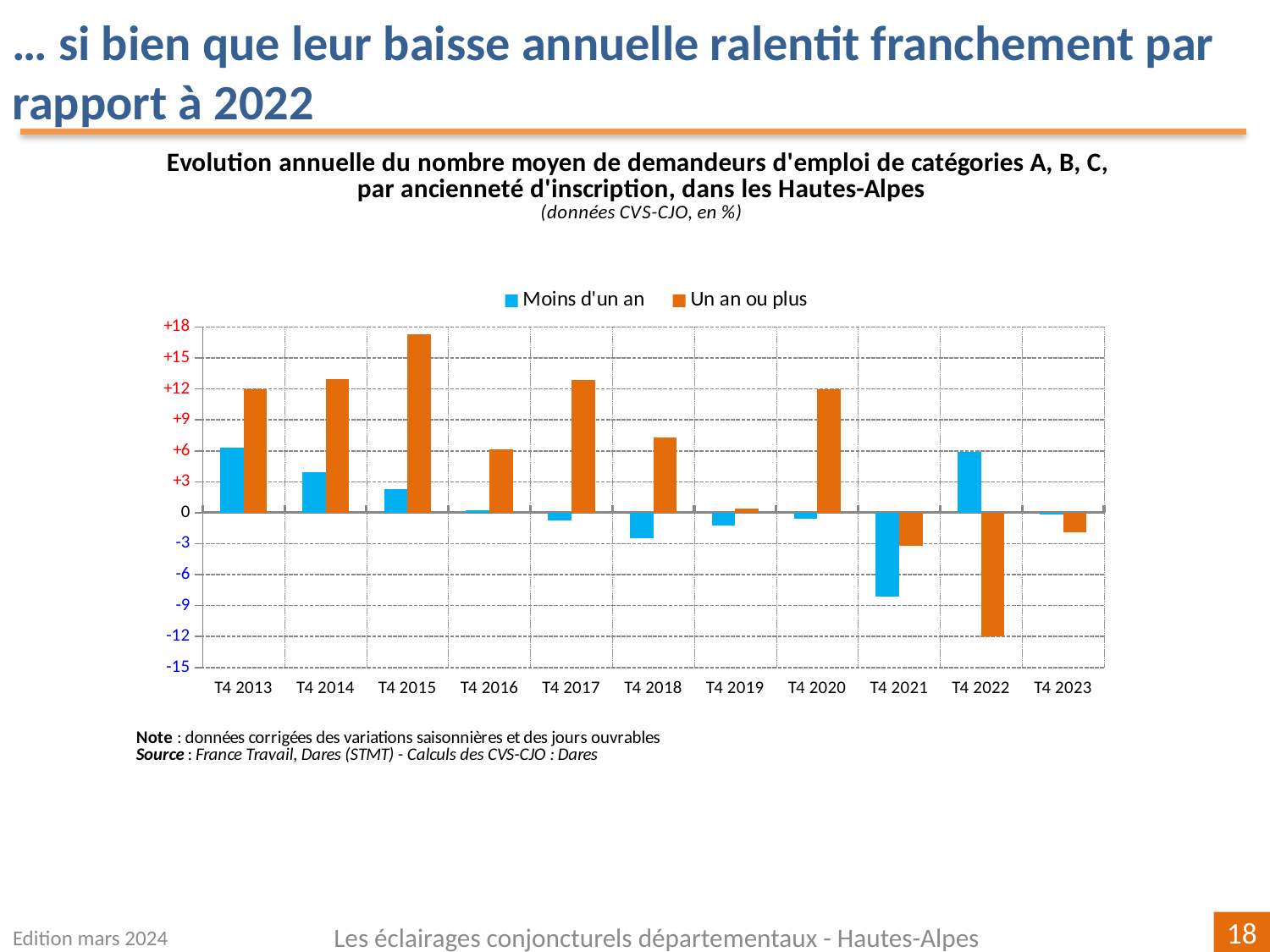
In which quarter is the value for 'Moins d'un an' the lowest? T4 2021 How many series does the legend list? 2 In T4 2022, which series has the higher value, 'Moins d'un an' or 'Un an ou plus'? Moins d'un an What kind of chart is shown on the slide? bar chart In T4 2013, which series has the higher value, 'Moins d'un an' or 'Un an ou plus'? Un an ou plus In which quarter is the value for 'Un an ou plus' the lowest? T4 2022 In which quarter is the value for 'Un an ou plus' the highest? T4 2015 How many quarters (categories) are shown on the x axis? 11 Is the value for 'Moins d'un an' in T4 2021 greater or less than -6? less Is the value for 'Un an ou plus' in T4 2022 greater or less than -9? less Does the value for 'Un an ou plus' rise or fall from T4 2020 to T4 2022? fall Is the value for 'Un an ou plus' in T4 2015 greater or less than +15? greater